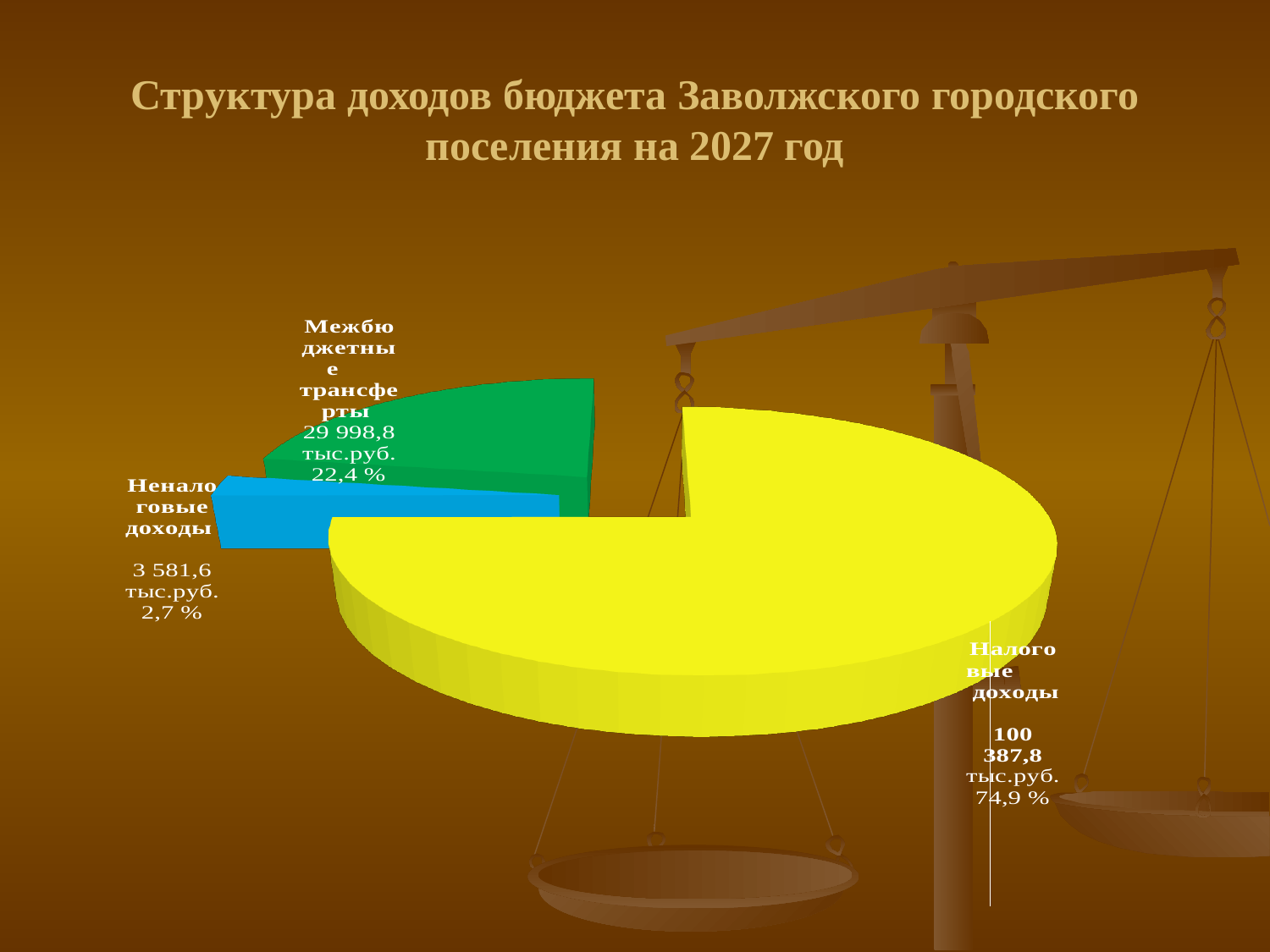
Which is larger, Межбюджетные трансферты or Неналоговые доходы? Межбюджетные трансферты How many slices does the pie chart have? 3 What is the value for Межбюджетные трансферты in тыс.руб.? 29 998,8 тыс.руб. What share of the pie is Межбюджетные трансферты? 22,4 % What is the title of the chart on the slide? Структура доходов бюджета Заволжского городского поселения на 2027 год What share of the pie is Неналоговые доходы? 2,7 % What kind of chart is shown on the slide? Pie chart What is the value for Неналоговые доходы in тыс.руб.? 3 581,6 тыс.руб. What is the value for Налоговые доходы in тыс.руб.? 100 387,8 тыс.руб. What share of the pie is Налоговые доходы? 74,9 % Which category has the largest slice of the pie? Налоговые доходы Which category has the smallest slice of the pie? Неналоговые доходы